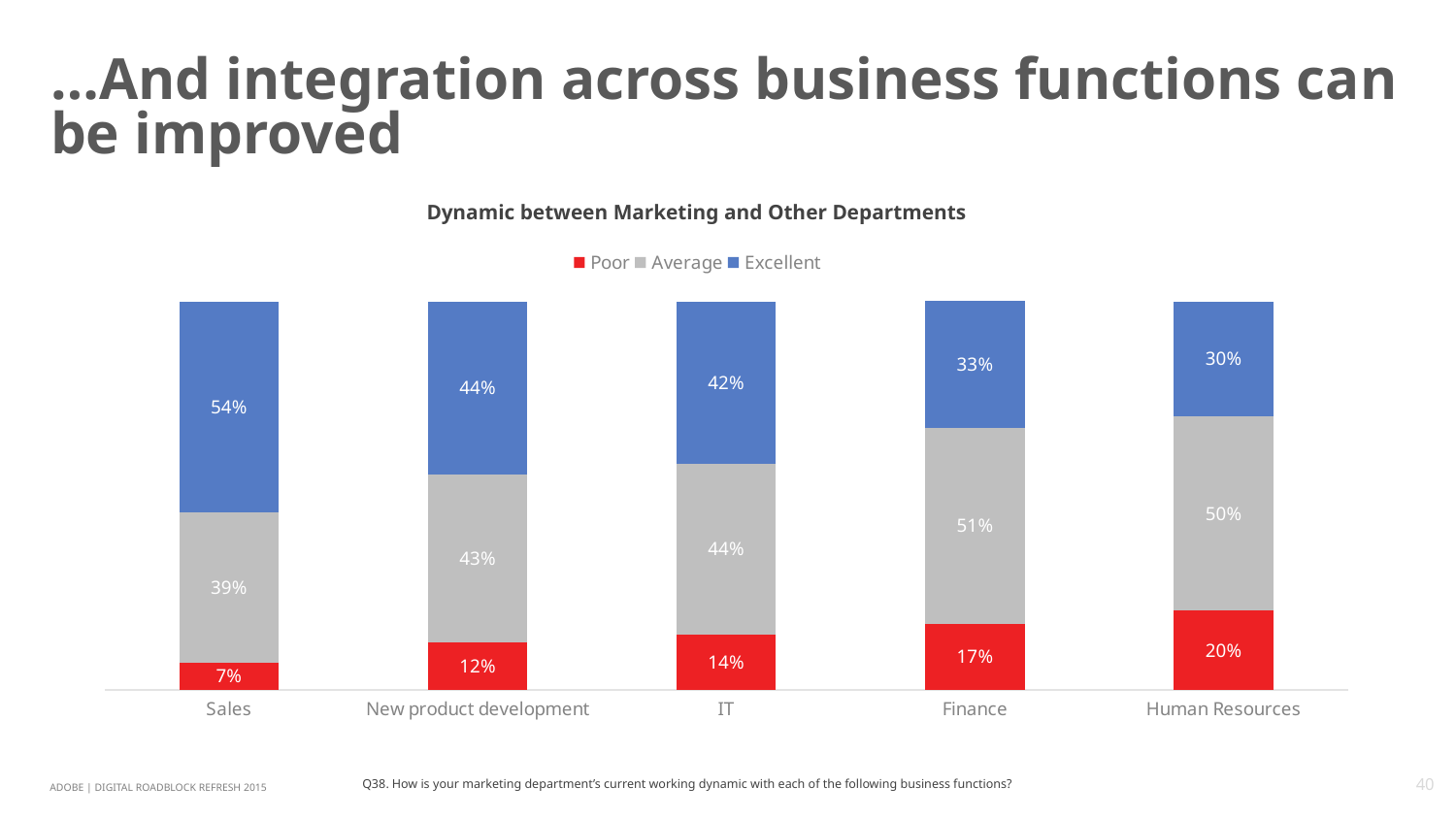
What kind of chart is shown? Stacked bar chart Which department has the lowest 'Poor' value? Sales What is the 'Excellent' value for Finance? 33% Which department has the highest 'Excellent' value? Sales Which department has the highest 'Poor' value? Human Resources What is the 'Poor' value for Sales? 7% What is the difference between the 'Excellent' values for Sales and Human Resources? 24% How many departments are shown on the x axis? 5 What is the 'Average' value for Human Resources? 50% How many series does the legend list? 3 Which is larger, the 'Poor' value for IT or the 'Poor' value for Finance? Finance Do the 'Poor' values rise or fall from Sales to Human Resources along the x axis? Rise